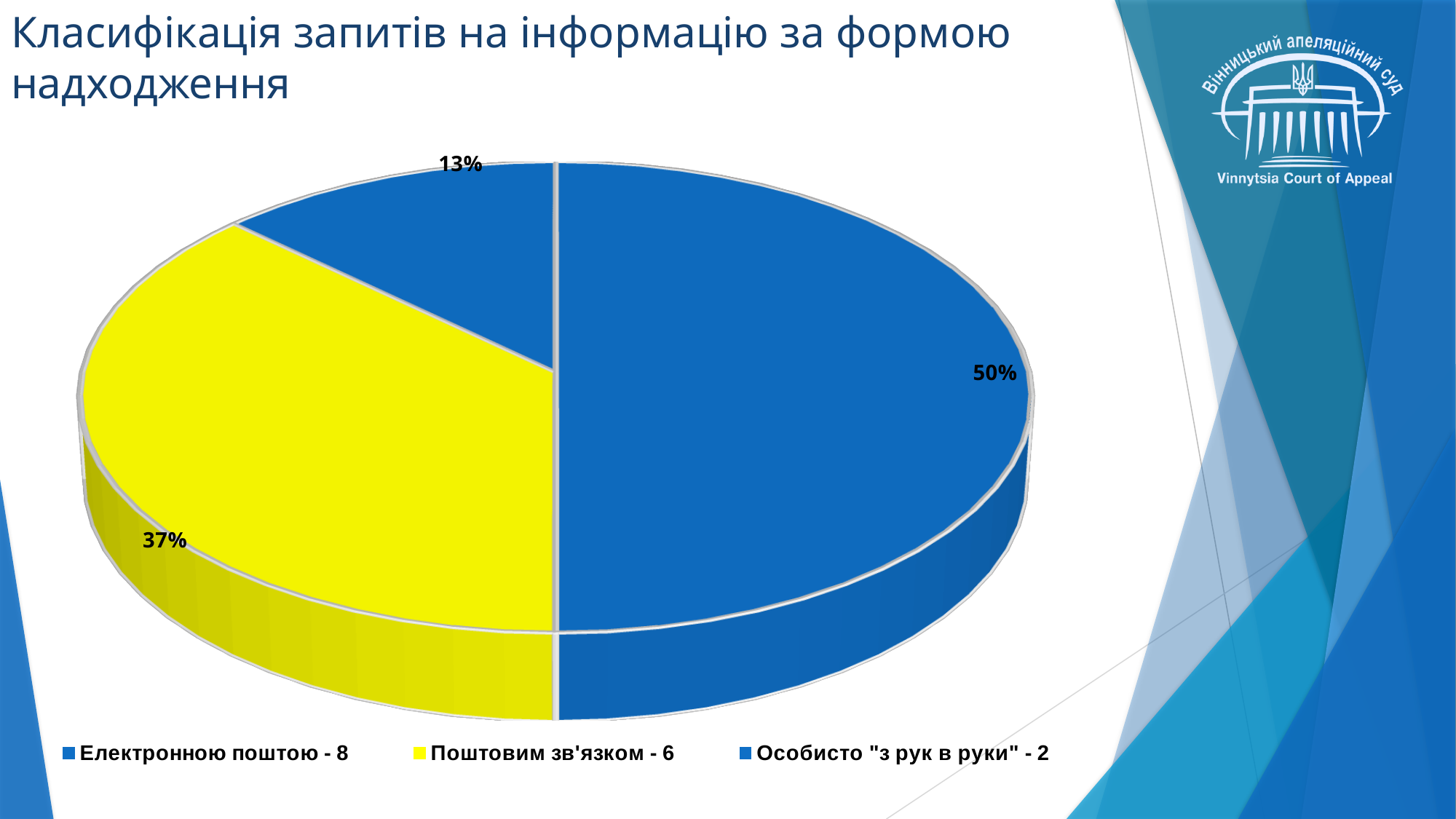
What kind of chart is shown on the slide? pie chart Which has the larger share: "Поштовим зв'язком" or "Особисто "з рук в руки""? Поштовим зв'язком How many slices does the pie chart have? 3 According to the legend, how many requests were received by "Поштовим зв'язком"? 6 What percentage of the pie is labelled for "Особисто "з рук в руки""? 13% What colour is the slice for "Поштовим зв'язком"? yellow What percentage of the pie is labelled for "Поштовим зв'язком"? 37% Which category has the largest share of the pie? Електронною поштою By how many percentage points does the share for "Електронною поштою" exceed the share for "Поштовим зв'язком"? 13 What percentage of the pie is labelled for "Електронною поштою"? 50% Which category has the smallest share of the pie? Особисто "з рук в руки" What is the total number of requests across all three categories listed in the legend? 16